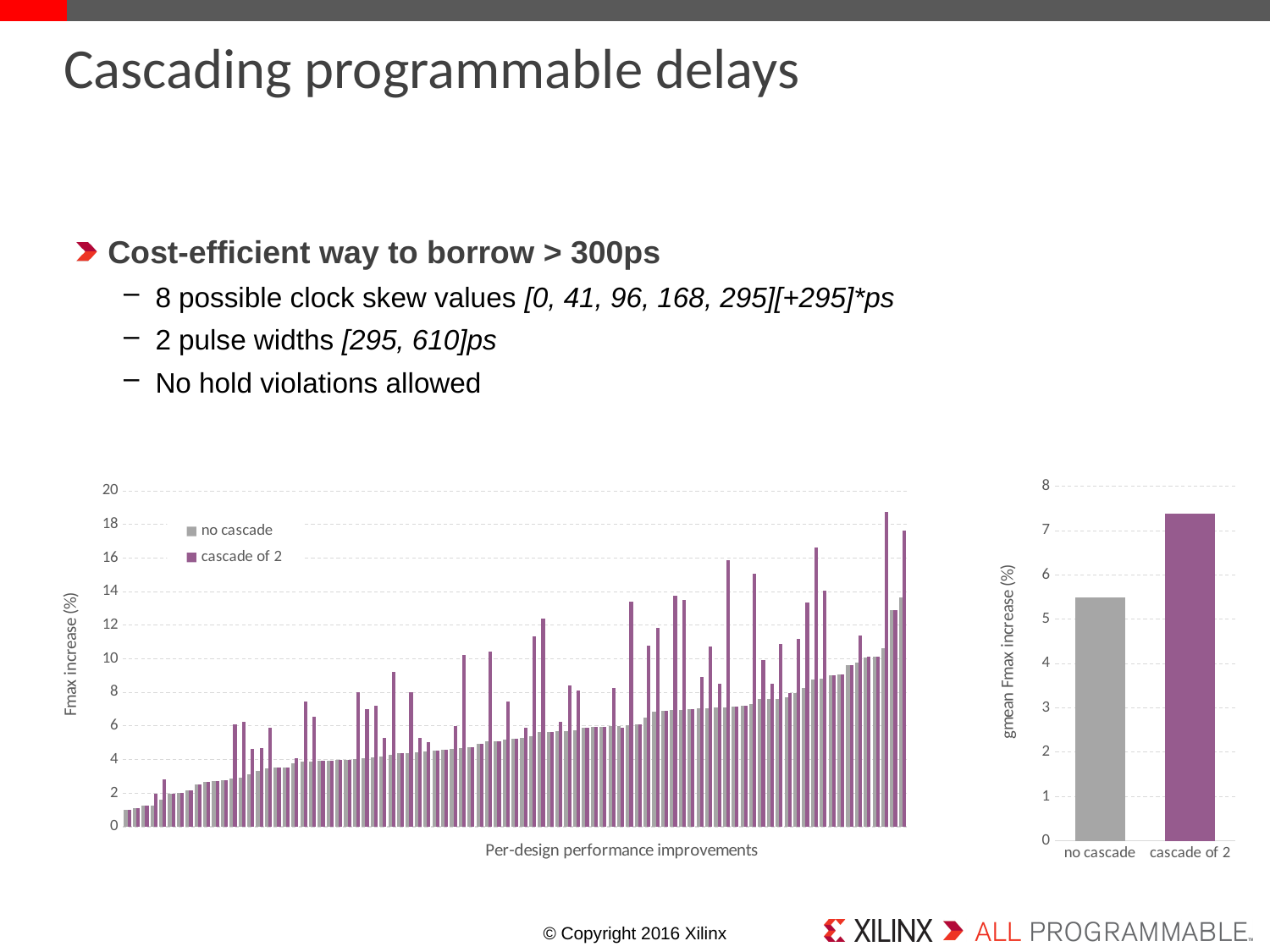
What kind of chart is the chart on the left of the slide, labelled 'Per-design performance improvements'? bar chart How many series does the legend of the left chart ('Per-design performance improvements') list? 2 In the chart on the right, is the value for 'cascade of 2' greater or less than 7? greater How many categories are shown on the x axis of the chart on the right? 2 What are the two series named in the legend of the left chart ('Per-design performance improvements')? no cascade, cascade of 2 What kind of chart is the chart on the right of the slide? bar chart In the chart on the right, which category has the higher gmean Fmax increase, 'no cascade' or 'cascade of 2'? cascade of 2 In the chart on the right, is the value for 'no cascade' greater or less than 5? greater In the chart on the right, is the value for 'cascade of 2' greater or less than 8? less What is the y-axis label of the chart on the right? gmean Fmax increase (%) In the left chart ('Per-design performance improvements'), do the 'no cascade' bars rise or fall from left to right along the x axis? rise